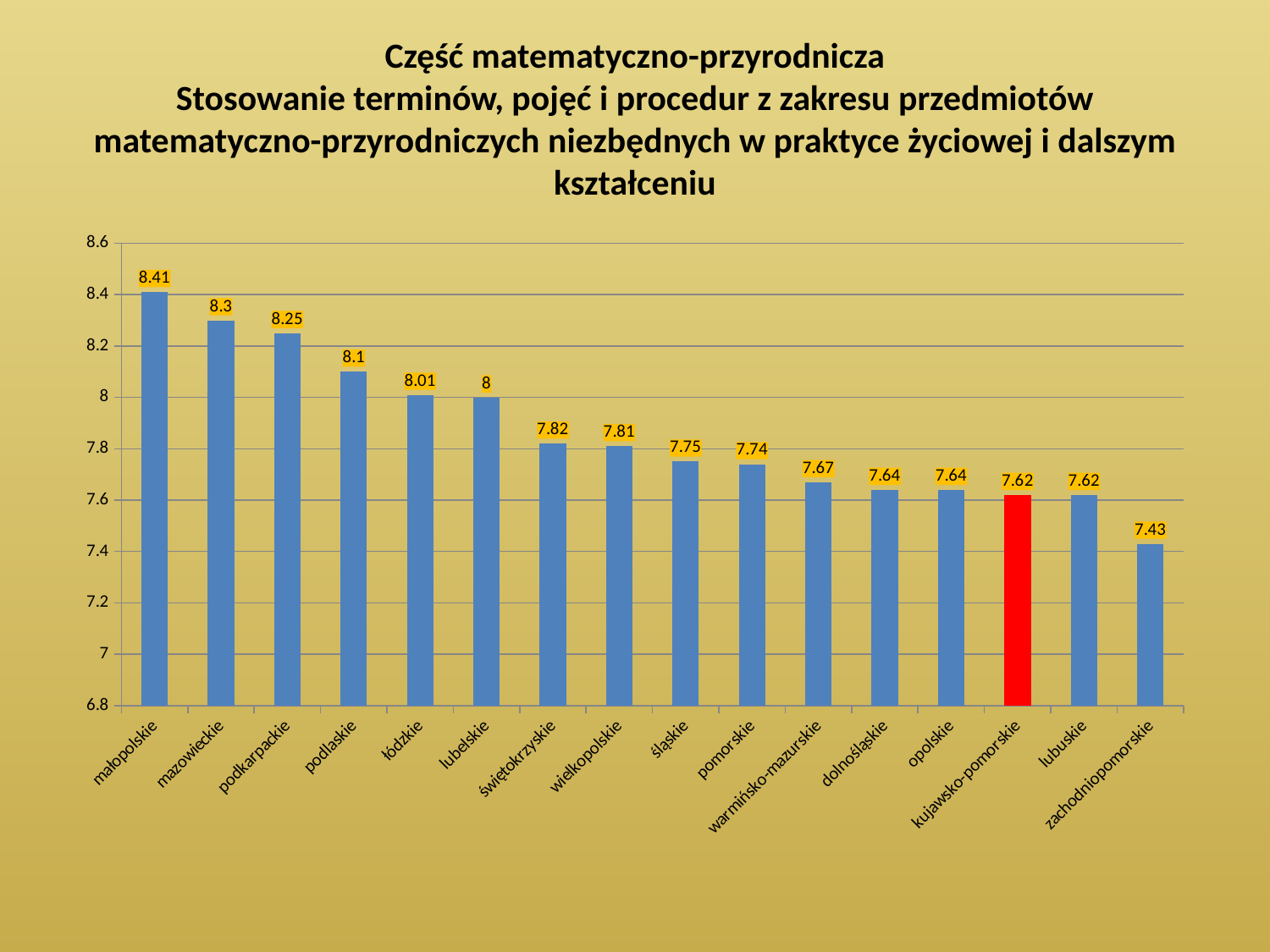
How many regions are shown on the chart? 16 What is the difference between the values for mazowieckie and podlaskie? 0.2 What is the value for kujawsko-pomorskie? 7.62 What is the value for małopolskie? 8.41 Which region has the lowest value? zachodniopomorskie Which region has the highest value? małopolskie Which is larger, the value for podkarpackie or the value for lubelskie? podkarpackie Which region's bar is coloured red? kujawsko-pomorskie What is the difference between the values for małopolskie and zachodniopomorskie? 0.98 What is the value for zachodniopomorskie? 7.43 Is the value for świętokrzyskie greater or less than 8? less What kind of chart is shown on the slide? bar chart